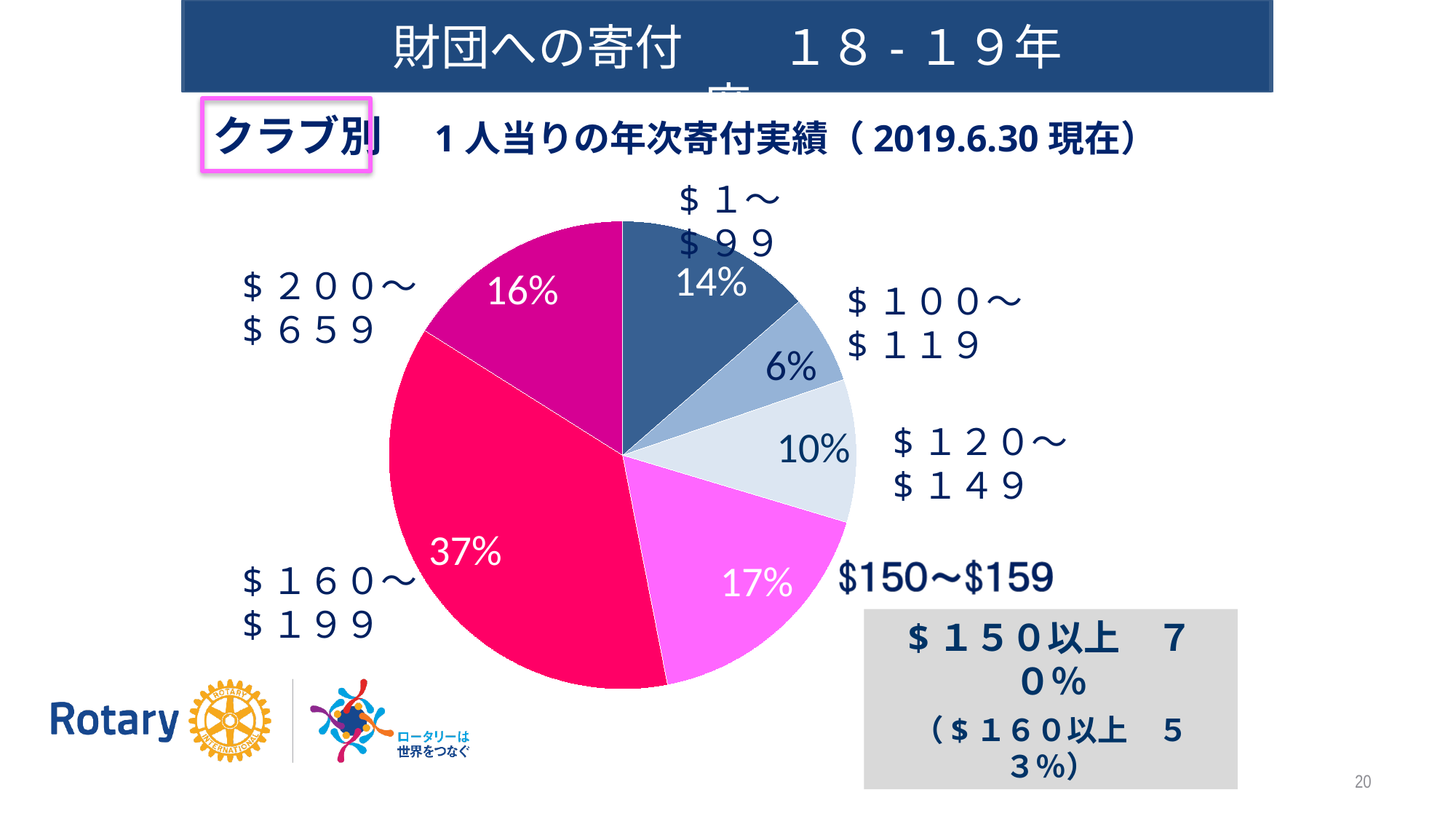
What share of the pie does the $１〜$９９ slice represent? 14% What share of the pie does the $２００〜$６５９ slice represent? 16% Which category has the largest slice of the pie? $１６０〜$１９９ What share of the pie does the $１６０〜$１９９ slice represent? 37% What kind of chart is shown on the slide? pie chart How many slices does the pie chart have? 6 Which category has the smallest slice of the pie? $１００〜$１１９ What share of the pie does the $１００〜$１１９ slice represent? 6% What is the difference in percentage points between the $１６０〜$１９９ slice and the $２００〜$６５９ slice? 21 What share of the pie does the $150〜$159 slice represent? 17% What share of the pie does the $１２０〜$１４９ slice represent? 10% Which slice is larger, $１〜$９９ or $１２０〜$１４９? $１〜$９９